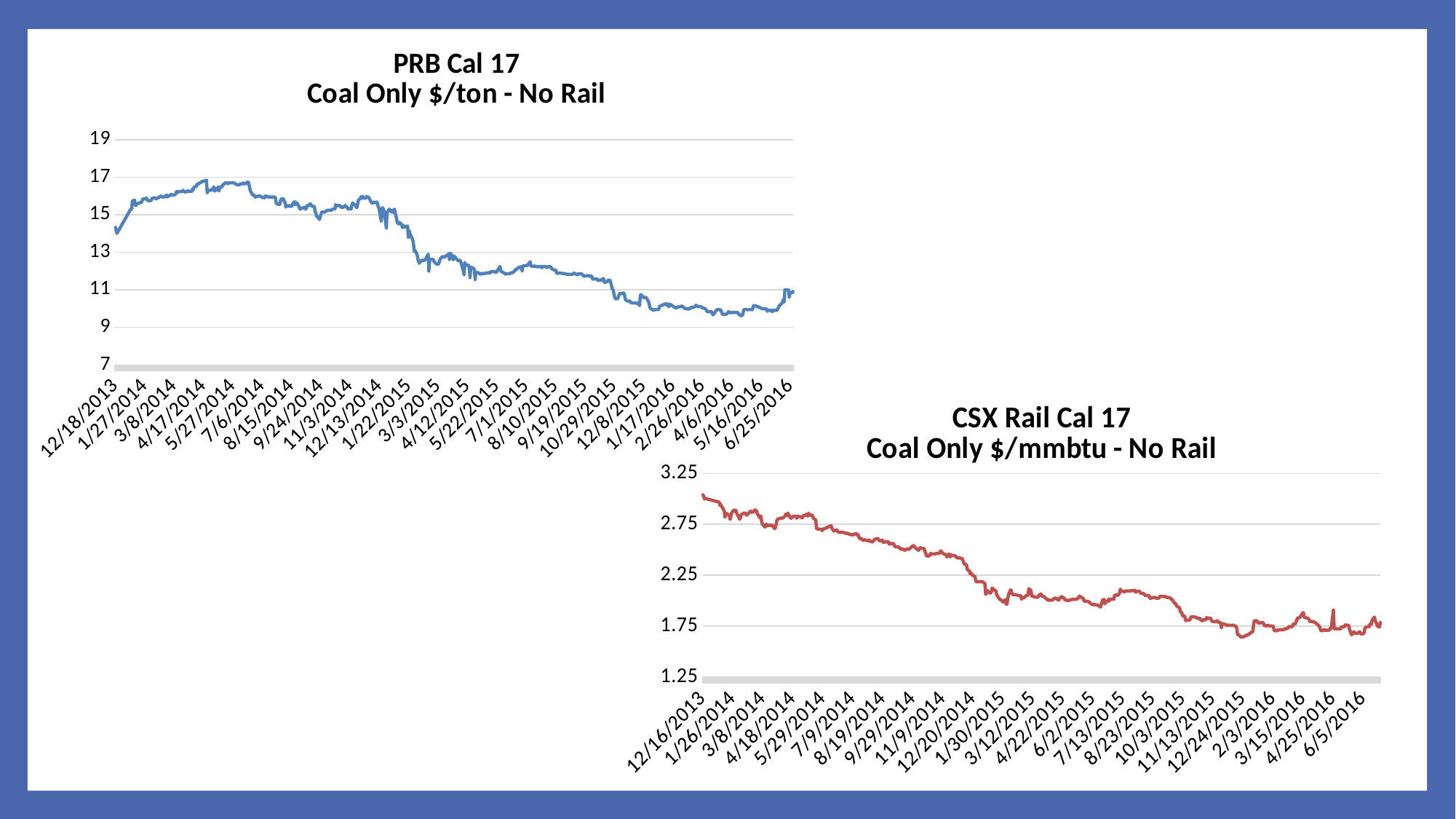
In the 'CSX Rail Cal 17' chart, do the values overall rise or fall from 12/16/2013 to 6/5/2016? fall In the 'PRB Cal 17' chart, is the value at 4/6/2016 greater or less than 11? less In the 'PRB Cal 17' chart, is the value at 12/18/2013 greater or less than 13? greater In the 'PRB Cal 17' chart, do the values overall rise or fall from 12/18/2013 to 6/25/2016? fall In the 'PRB Cal 17' chart, is the value at 12/18/2013 larger or smaller than the value at 6/25/2016? larger What kind of chart is the 'CSX Rail Cal 17 Coal Only $/mmbtu - No Rail' chart? line chart What kind of chart is the 'PRB Cal 17 Coal Only $/ton - No Rail' chart? line chart What colour is the line in the 'PRB Cal 17' chart? blue In the 'CSX Rail Cal 17' chart, is the value at 12/16/2013 greater or less than 2.75? greater What unit is shown in the title of the 'CSX Rail Cal 17' chart? $/mmbtu